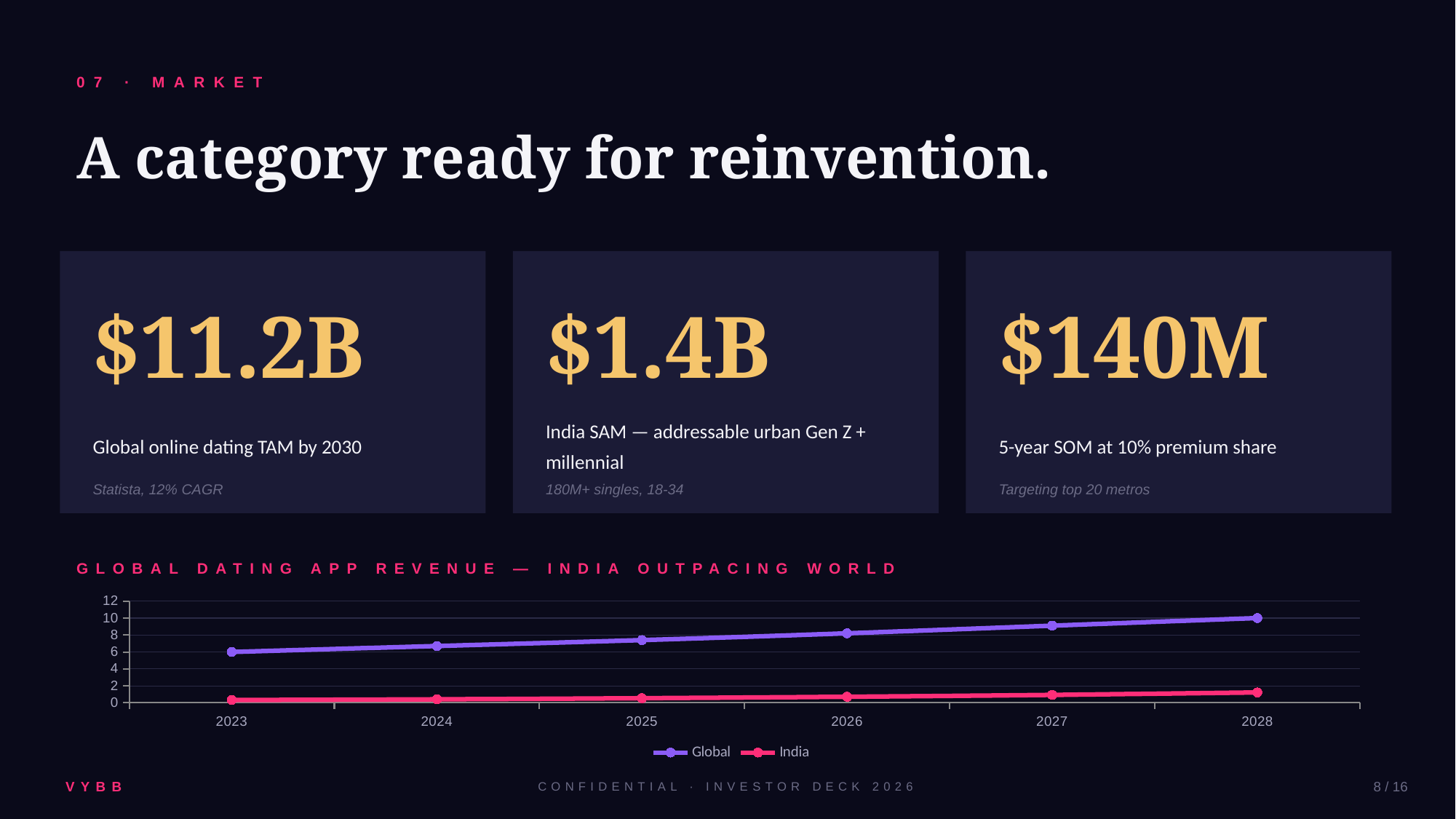
Which series is drawn in purple in the revenue chart? Global Does the Global series rise or fall from 2023 to 2028? rise In which year is the Global series at its highest? 2028 How many years are plotted along the x axis of the revenue chart? 6 Is the India value for 2028 greater or less than 2? less Is the Global value for 2025 greater or less than 6? greater What kind of chart is shown under the heading 'Global dating app revenue — India outpacing world'? line chart In which year is the India series at its lowest? 2023 Is the Global value for 2027 greater or less than 10? less How many series does the legend of the revenue chart list? 2 Does the India series rise or fall from 2023 to 2028? rise In 2026, which series has the larger value, Global or India? Global